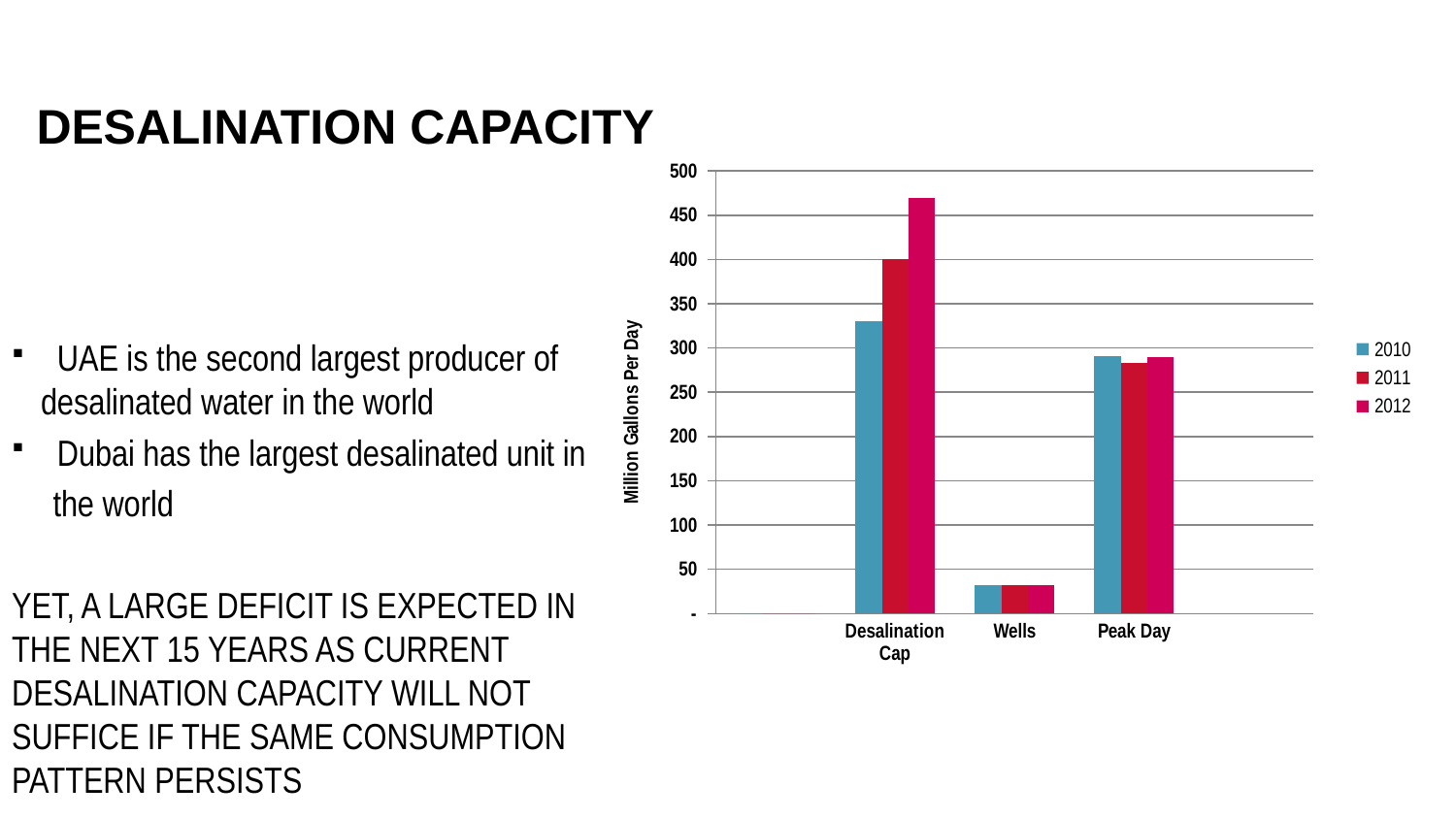
How many categories are shown on the x axis of the chart? 3 For Desalination Cap, which year has the larger value, 2010 or 2012? 2012 Is the value for Desalination Cap in 2010 greater or less than 300? greater What kind of chart is shown on the slide? bar chart Is the value for Wells in 2011 greater or less than 50? less Is the value for Desalination Cap in 2012 greater or less than 450? greater Which category has the highest value for 2012? Desalination Cap What is the label on the y axis of the chart? Million Gallons Per Day How many series does the chart's legend list? 3 Does the value for Desalination Cap rise or fall from 2010 to 2012? rise Which category has the lowest value for 2010? Wells